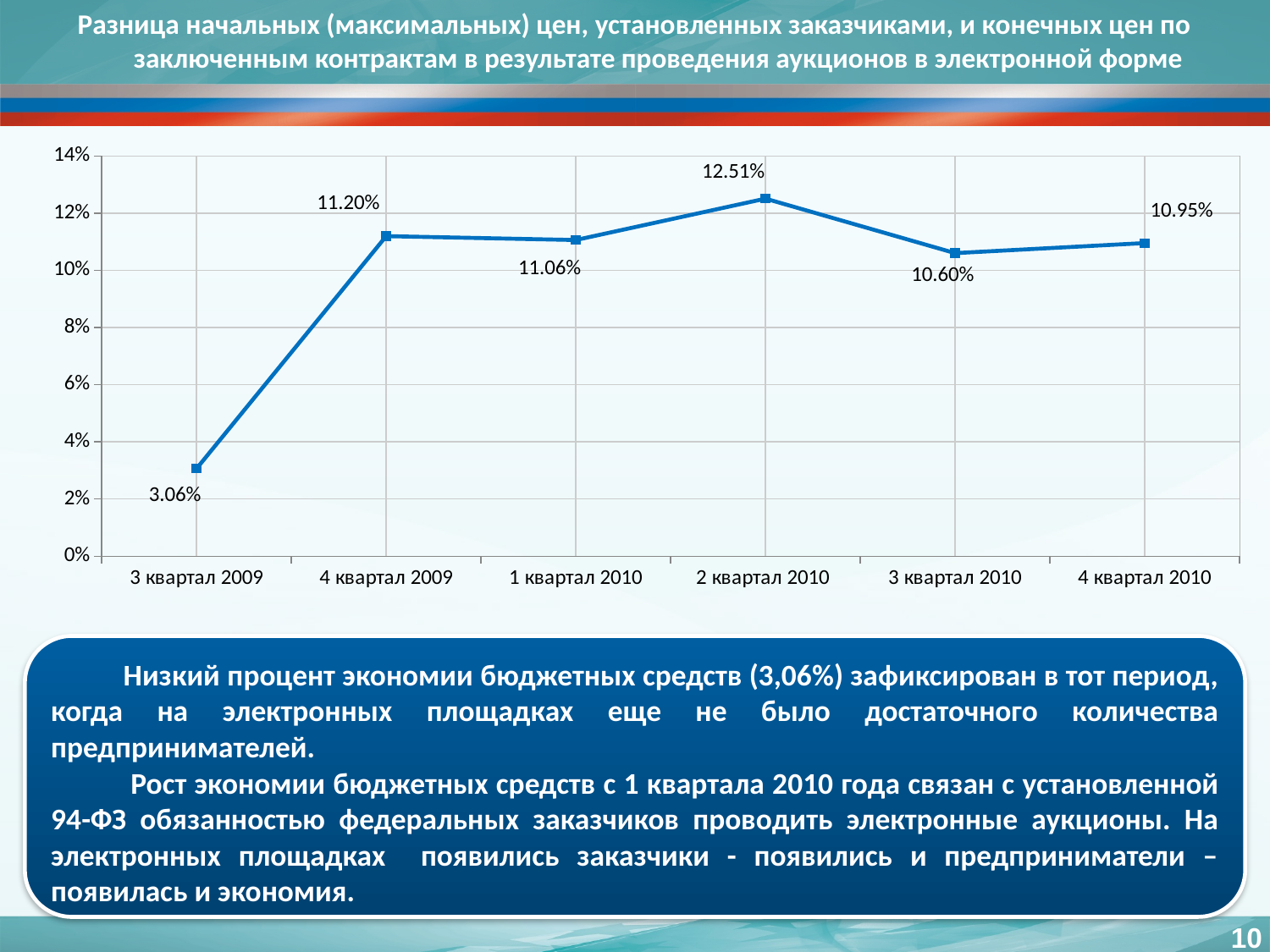
What is the value for 3 квартал 2010? 10.60% What kind of chart is shown on the slide? line chart What is the value for 2 квартал 2010? 12.51% What is the value for 3 квартал 2009? 3.06% Which quarter has the highest value? 2 квартал 2010 What is the difference between the values for 4 квартал 2009 and 3 квартал 2009? 8.14% Which quarter has the lowest value? 3 квартал 2009 How many quarters are plotted on the chart? 6 Which is larger, the value for 4 квартал 2009 or the value for 1 квартал 2010? 4 квартал 2009 What is the value for 4 квартал 2010? 10.95% Does the value rise or fall from 3 квартал 2009 to 4 квартал 2009? rise Is the value for 2 квартал 2010 greater or less than 12%? greater